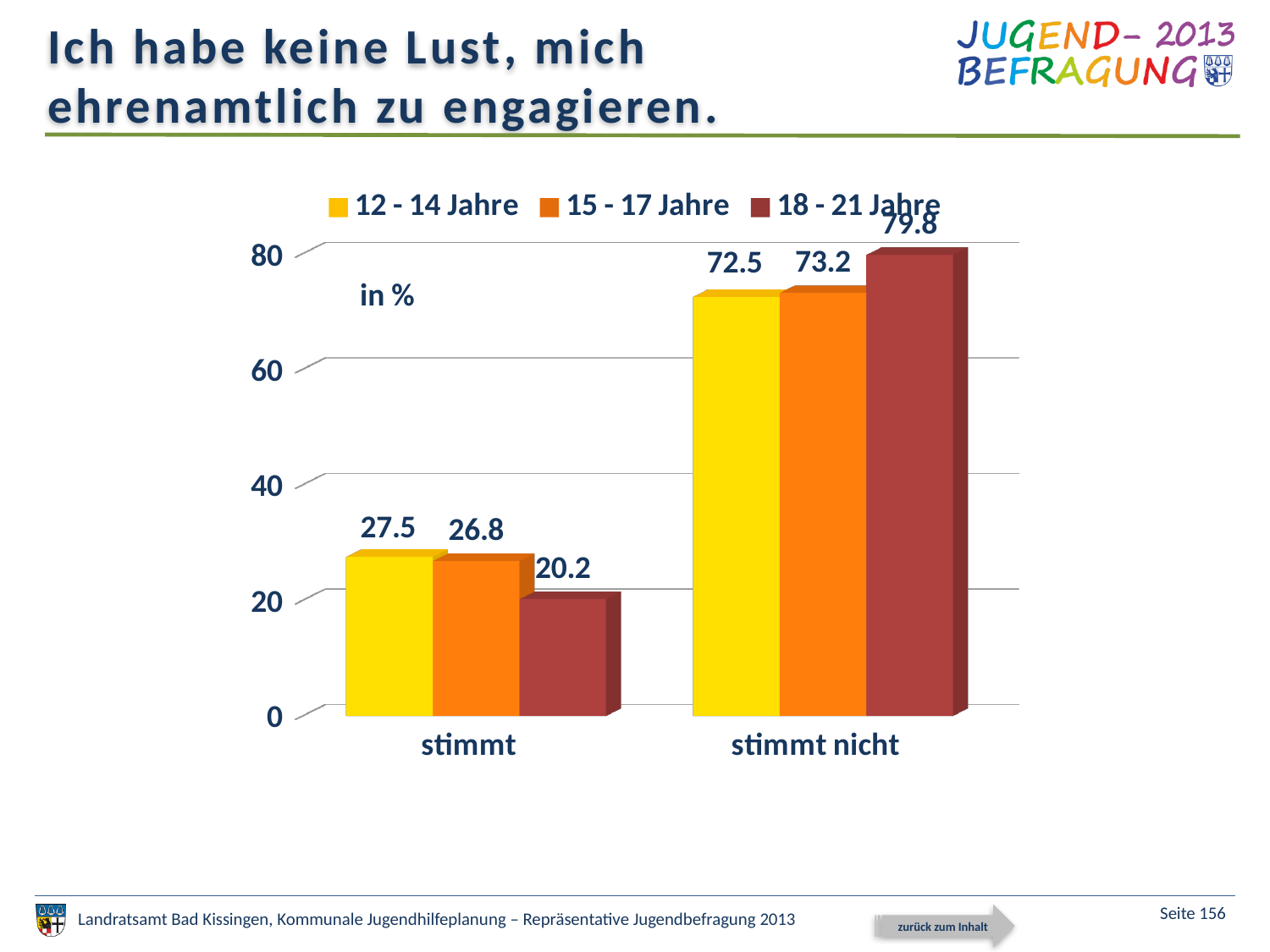
Which age group has the lowest value in the "stimmt" category? 18 - 21 Jahre How many categories are shown on the x axis? 2 How many series does the legend list? 3 What is the value for the 15 - 17 Jahre series in the "stimmt" category? 26.8 What kind of chart is shown on the slide? bar chart Is the value for 15 - 17 Jahre in the "stimmt nicht" category greater or less than 60? greater What is the value for the 18 - 21 Jahre series in the "stimmt nicht" category? 79.8 What is the difference between the 12 - 14 Jahre and 18 - 21 Jahre values in the "stimmt" category? 7.3 What is the difference between the 18 - 21 Jahre and 12 - 14 Jahre values in the "stimmt nicht" category? 7.3 What is the value for the 12 - 14 Jahre series in the "stimmt" category? 27.5 Which age group has the highest value in the "stimmt nicht" category? 18 - 21 Jahre Which is larger: the 12 - 14 Jahre value for "stimmt" or the 18 - 21 Jahre value for "stimmt"? 12 - 14 Jahre